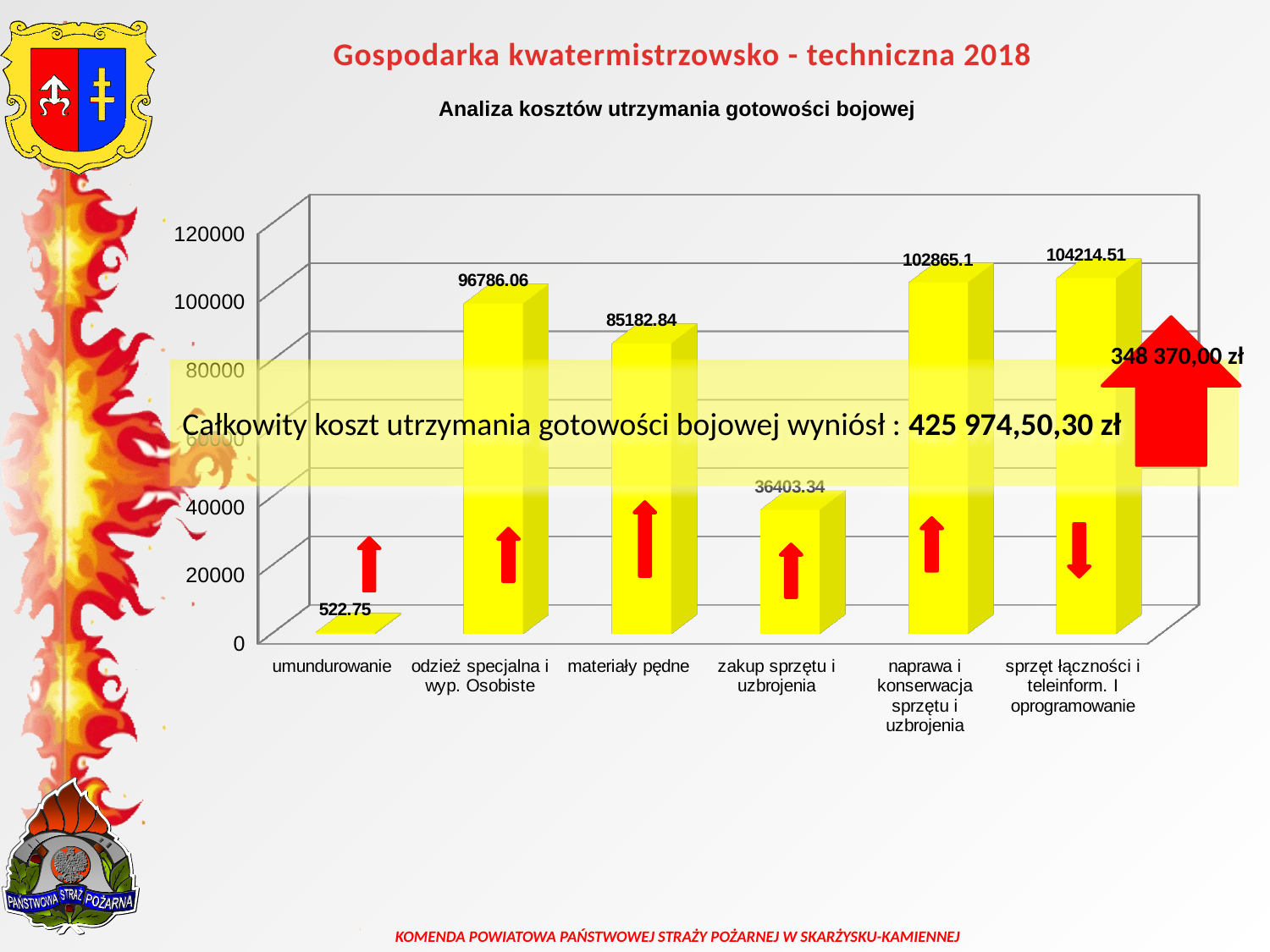
What is the value for zakup sprzętu i uzbrojenia? 36403.34 What kind of chart is shown on the slide? bar chart What is the difference between the values for odzież specjalna i wyp. Osobiste and materiały pędne? 11603.22 What is the value for materiały pędne? 85182.84 Which category has the highest value? sprzęt łączności i teleinform. I oprogramowanie How many categories are shown on the chart? 6 Which category has the lowest value? umundurowanie Which is larger: the value for odzież specjalna i wyp. Osobiste or the value for zakup sprzętu i uzbrojenia? odzież specjalna i wyp. Osobiste Is the value for materiały pędne greater or less than 80000? greater What is the title of the chart? Analiza kosztów utrzymania gotowości bojowej What is the value for naprawa i konserwacja sprzętu i uzbrojenia? 102865.1 What is the value for umundurowanie? 522.75